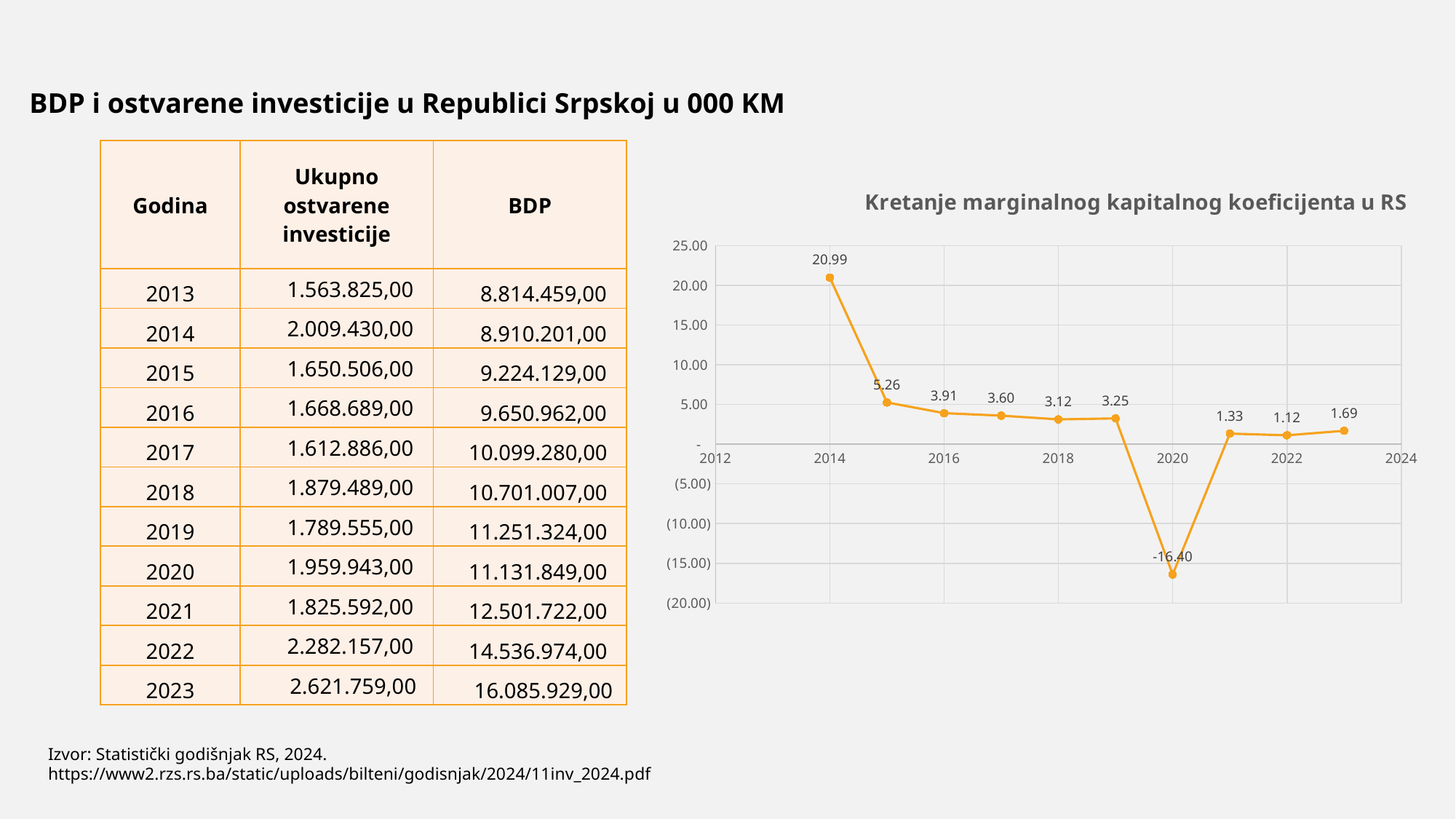
What is the value of the marginal capital coefficient in 2020? -16.40 What is the value of the marginal capital coefficient in 2023? 1.69 What is the value of the marginal capital coefficient in 2014? 20.99 What kind of chart is shown on the slide? line chart In which year is the marginal capital coefficient highest? 2014 Does the marginal capital coefficient rise or fall from 2014 to 2018? fall Which is larger, the value for 2018 or the value for 2019? 2019 What is the title of the chart? Kretanje marginalnog kapitalnog koeficijenta u RS How many data points are plotted on the line chart? 10 In which year is the marginal capital coefficient lowest? 2020 What is the difference between the 2014 value (20.99) and the 2015 value (5.26)? 15.73 Is the value for 2016 greater or less than 5.00? less